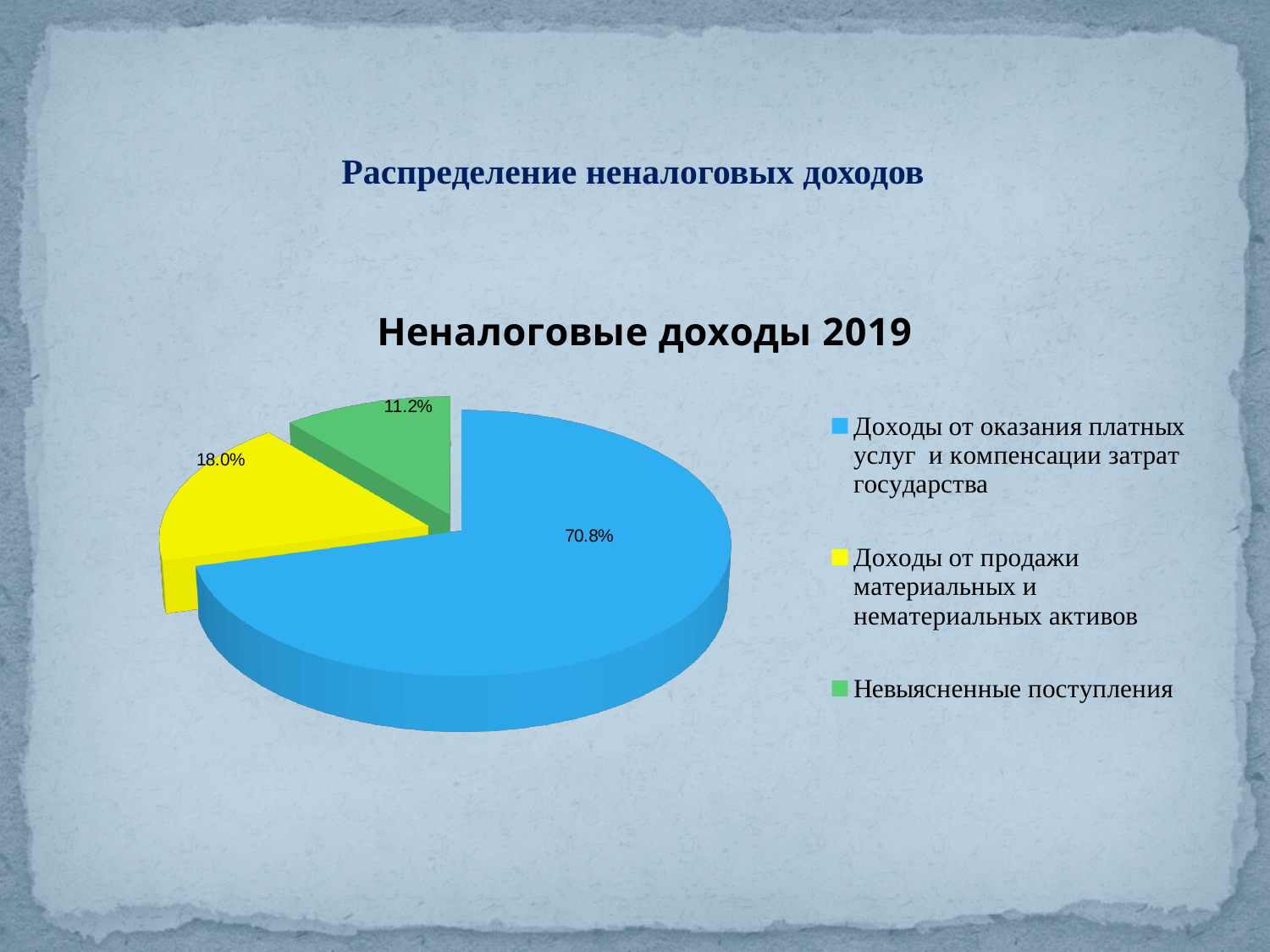
Which category has the largest slice of the pie? Доходы от оказания платных услуг и компенсации затрат государства What is the difference in percentage points between the slice for 'Доходы от продажи материальных и нематериальных активов' and the slice for 'Невыясненные поступления'? 6.8 What share of the pie is labelled for 'Доходы от оказания платных услуг и компенсации затрат государства'? 70.8% Which is larger: the slice for 'Доходы от продажи материальных и нематериальных активов' or the slice for 'Невыясненные поступления'? Доходы от продажи материальных и нематериальных активов What share of the pie is labelled for 'Невыясненные поступления'? 11.2% What share of the pie is labelled for 'Доходы от продажи материальных и нематериальных активов'? 18.0% What is the difference in percentage points between the largest slice and the smallest slice? 59.6 How many categories does the legend list? 3 Which category has the smallest slice of the pie? Невыясненные поступления What kind of chart is shown on the slide? Pie chart What colour is the slice for 'Невыясненные поступления'? Green What is the title of the chart? Неналоговые доходы 2019